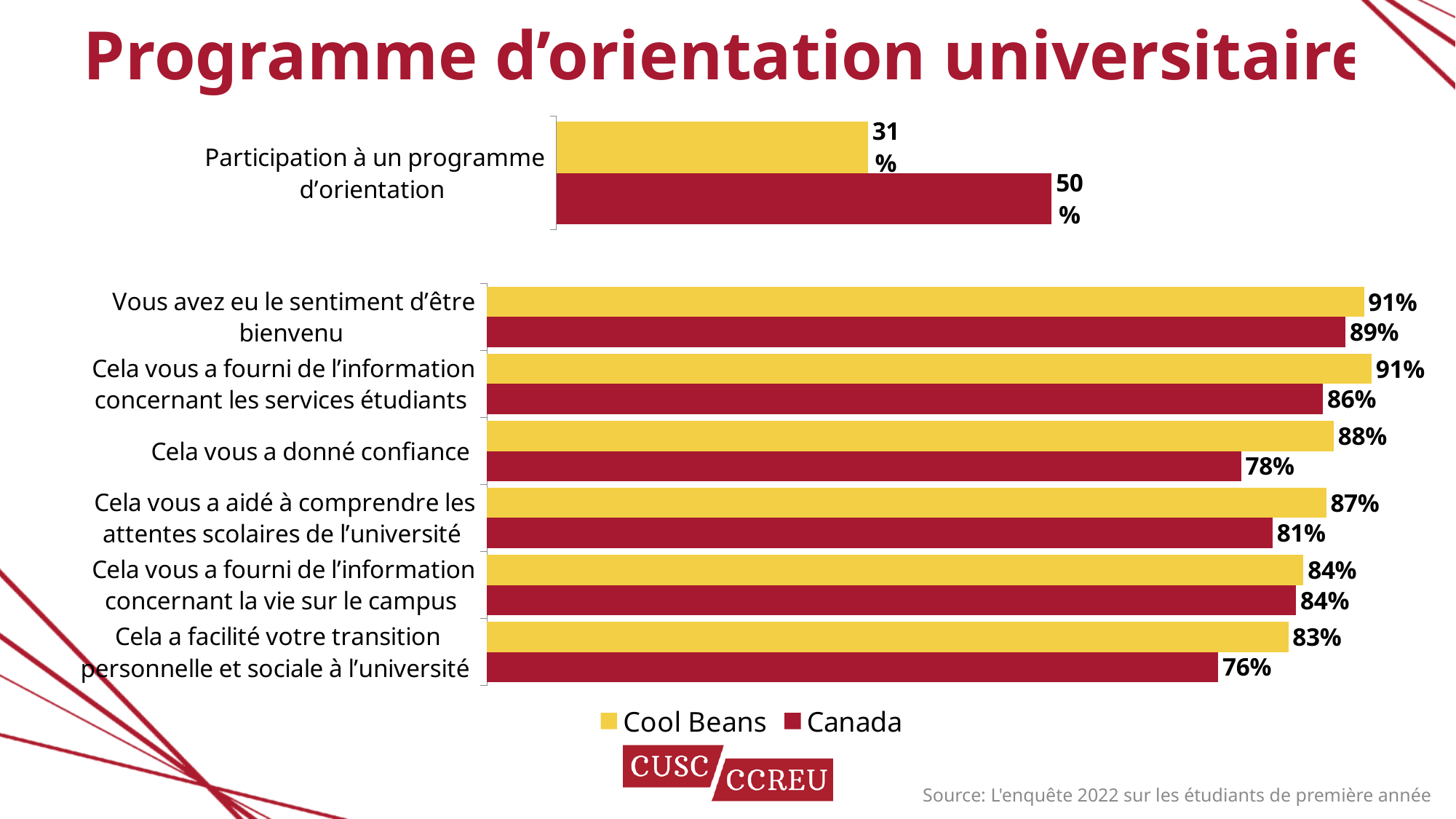
In the bottom chart, what is the Canada value for 'Cela vous a fourni de l'information concernant la vie sur le campus'? 84% In the top chart, what is the difference between the Canada and Cool Beans values for participation in an orientation programme? 19% In the bottom chart, which is larger for 'Cela vous a aidé à comprendre les attentes scolaires de l'université': the Cool Beans value or the Canada value? Cool Beans In the top chart, what is the value for Canada for 'Participation à un programme d'orientation'? 50% In the bottom chart, which category has the lowest Canada value? Cela a facilité votre transition personnelle et sociale à l'université In the top chart, what is the value for Cool Beans for 'Participation à un programme d'orientation'? 31% In the bottom chart, what is the Canada value for 'Cela a facilité votre transition personnelle et sociale à l'université'? 76% In the bottom chart, what is the difference between the Cool Beans and Canada values for 'Cela vous a donné confiance'? 10% What type of chart is the bottom chart? Bar chart In the bottom chart, how many categories are shown? 6 In the bottom chart, what is the Cool Beans value for 'Cela vous a donné confiance'? 88% How many series does the legend at the bottom of the slide list? 2